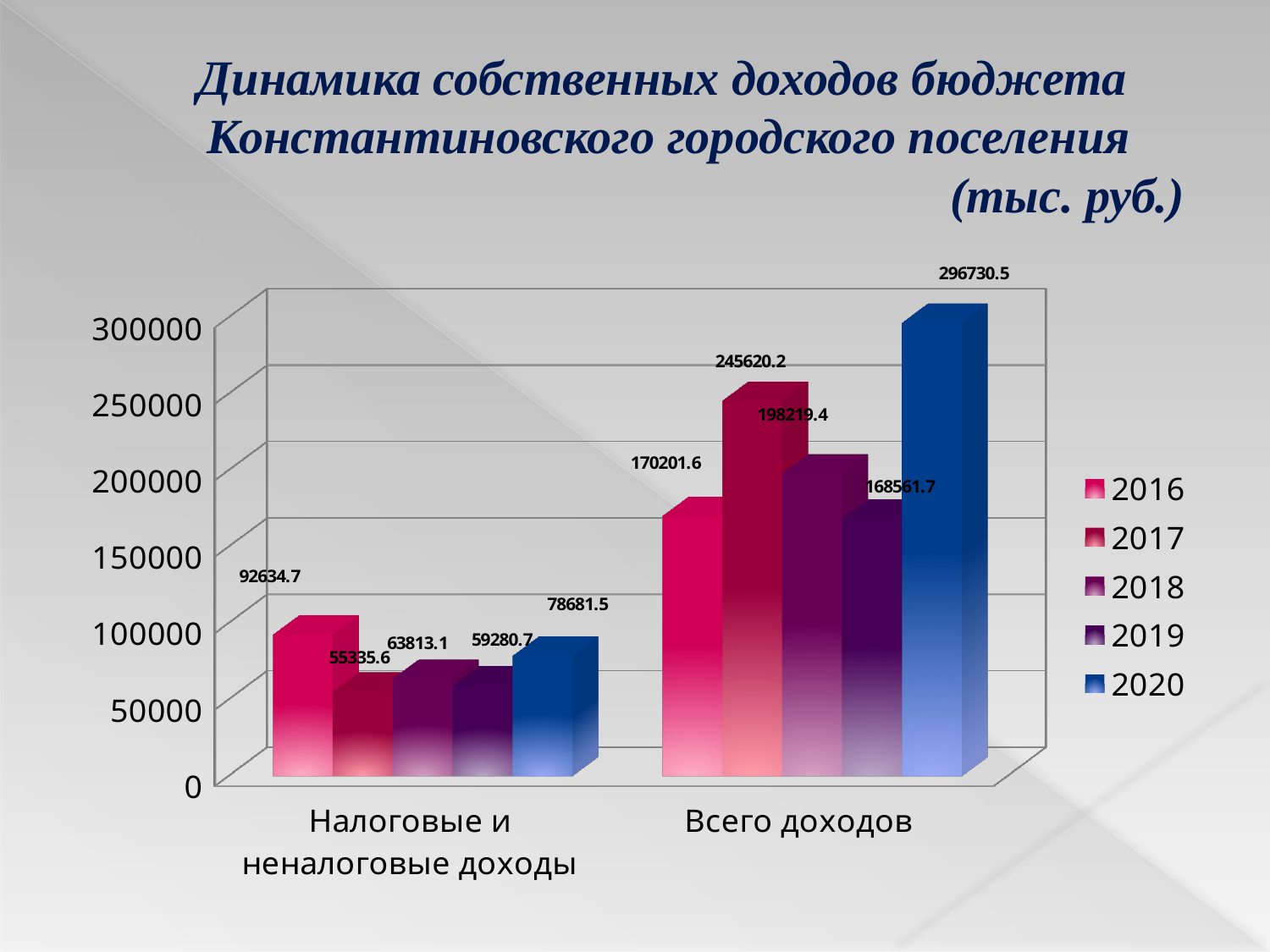
What is the value for 2017 in the "Всего доходов" category? 245620.2 What is the value for 2016 in the "Налоговые и неналоговые доходы" category? 92634.7 Which year has the lowest value in the "Налоговые и неналоговые доходы" category? 2017 How many series does the legend list? 5 What is the value for 2019 in the "Налоговые и неналоговые доходы" category? 59280.7 Which year has the highest value in the "Всего доходов" category? 2020 How many categories are shown on the x axis? 2 Which is larger in the "Налоговые и неналоговые доходы" category: the 2018 value or the 2020 value? 2020 What kind of chart is shown on the slide? bar chart What is the difference between the 2020 and 2019 values in the "Всего доходов" category? 128168.8 What is the value for 2020 in the "Всего доходов" category? 296730.5 Is the 2016 value for "Всего доходов" greater or less than 200000? less